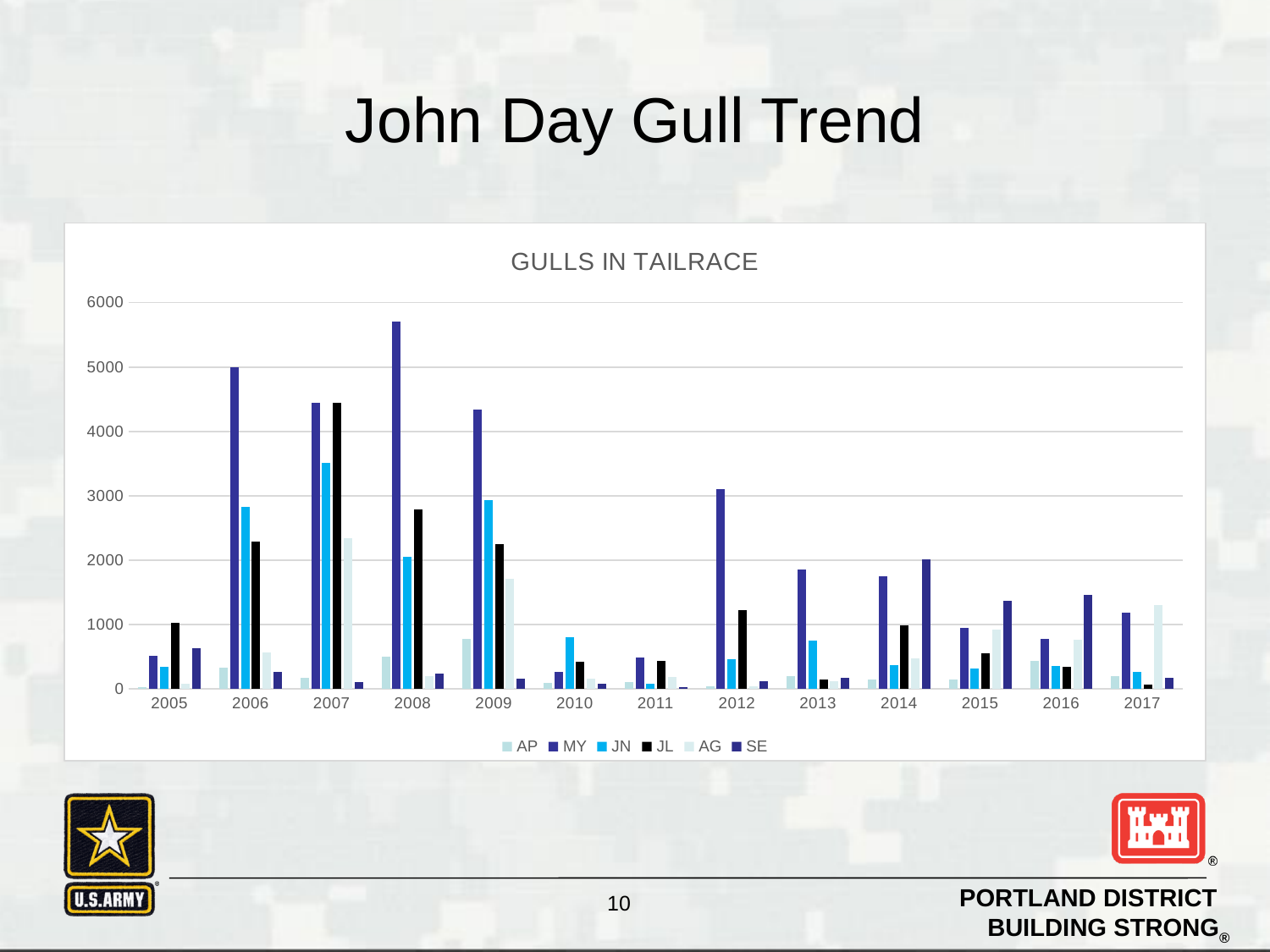
Which year contains the tallest bar in the chart? 2008 Is the MY value for 2012 greater or less than 2000? greater Does the MY value rise or fall from 2008 to 2011? fall What kind of chart is shown on the slide? bar chart Is the JL value for 2005 greater or less than 500? greater Is the JN value for 2007 greater or less than 3000? greater What is the title of the chart? GULLS IN TAILRACE How many years are shown along the x axis of the chart? 13 How many series does the legend list? 6 Which is larger, the MY value for 2008 or the MY value for 2009? 2008 Which series is listed first in the legend? AP